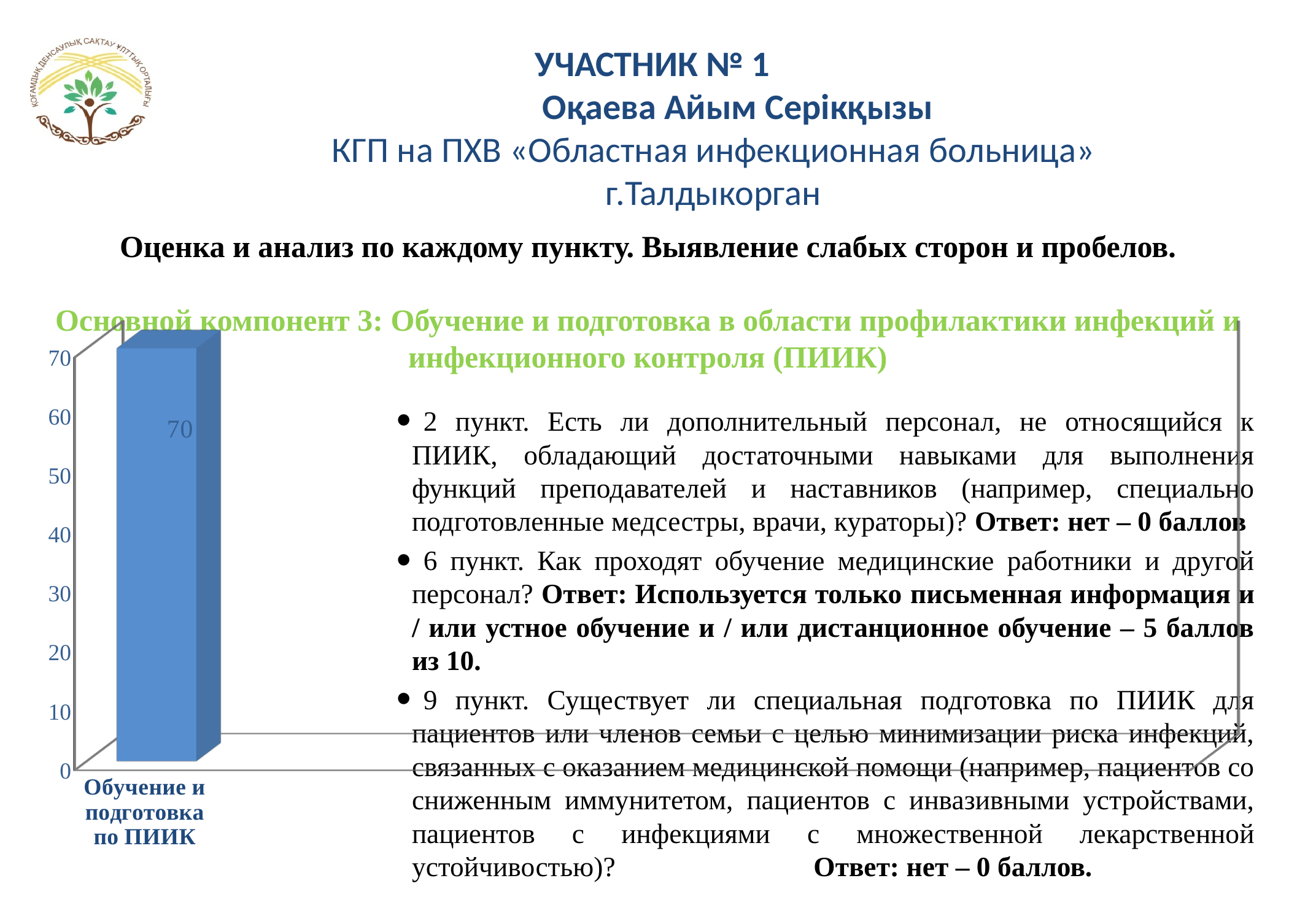
How many bars are plotted in the chart? 1 Is the value for "Обучение и подготовка по ПИИК" greater or less than 50? greater What is the highest value shown on the vertical axis of the chart? 70 What is the category label shown under the bar? Обучение и подготовка по ПИИК What colour is the bar in the chart? blue Is the value for "Обучение и подготовка по ПИИК" greater or less than 60? greater What is the value of the bar for "Обучение и подготовка по ПИИК"? 70 What kind of chart is shown on the slide? bar chart